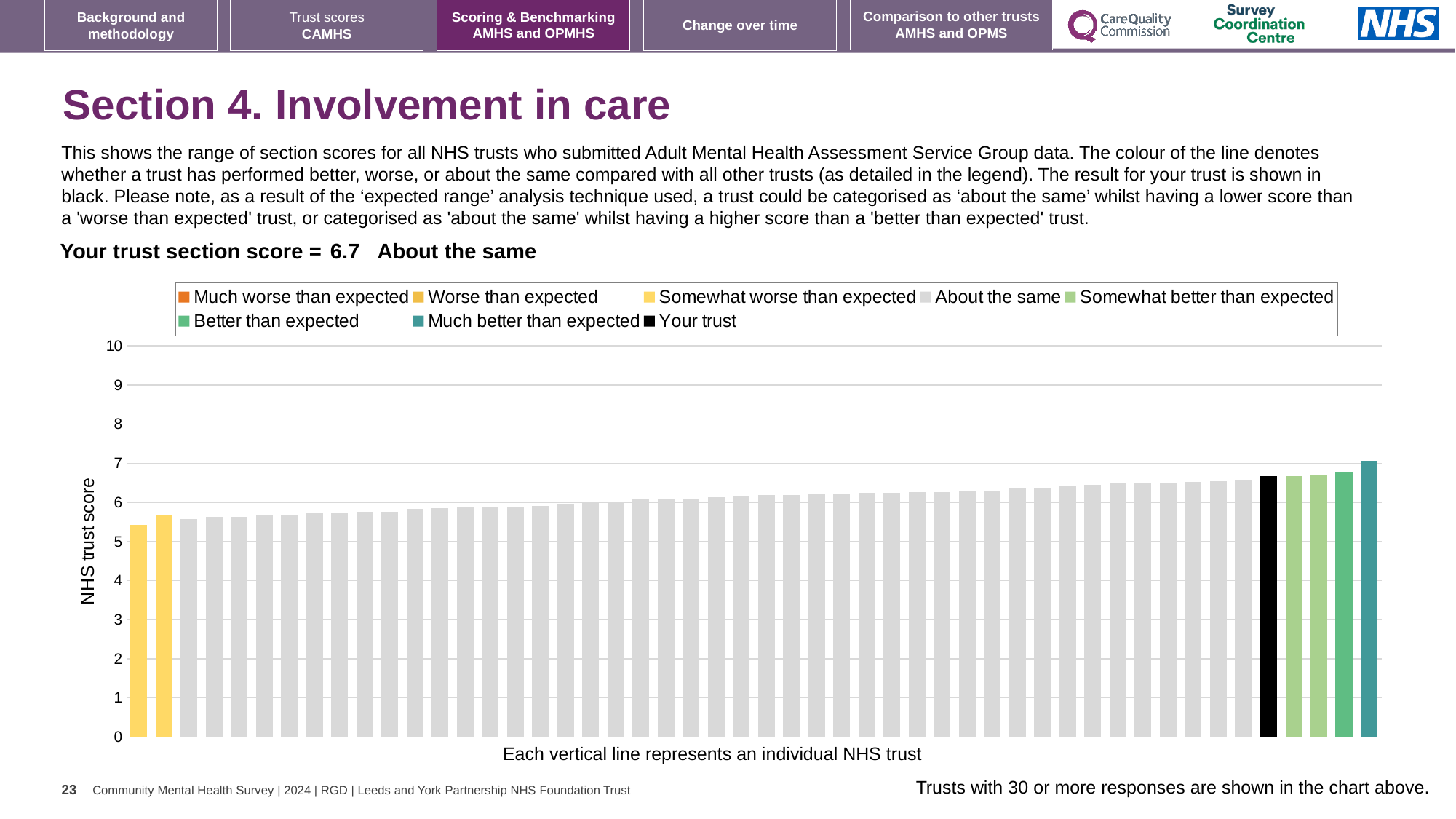
Is the value of the highest bar in the chart greater or less than 8? less Which category is your trust placed in for this section? About the same What is the label on the vertical axis of the chart? NHS trust score Is the black 'Your trust' bar higher or lower than the teal 'Much better than expected' bar? Lower Is the value for your trust (black bar) greater or less than 6? greater What type of chart is shown on the slide? Bar chart How many bars are coloured as 'Much better than expected' (teal)? 1 What is the section score for your trust shown on the slide? 6.7 How many entries does the chart legend list? 8 Is the value of the lowest bar in the chart greater or less than 6? less Do the bar values rise or fall from left to right across the chart? Rise How many bars are coloured as 'Somewhat worse than expected' (yellow)? 2